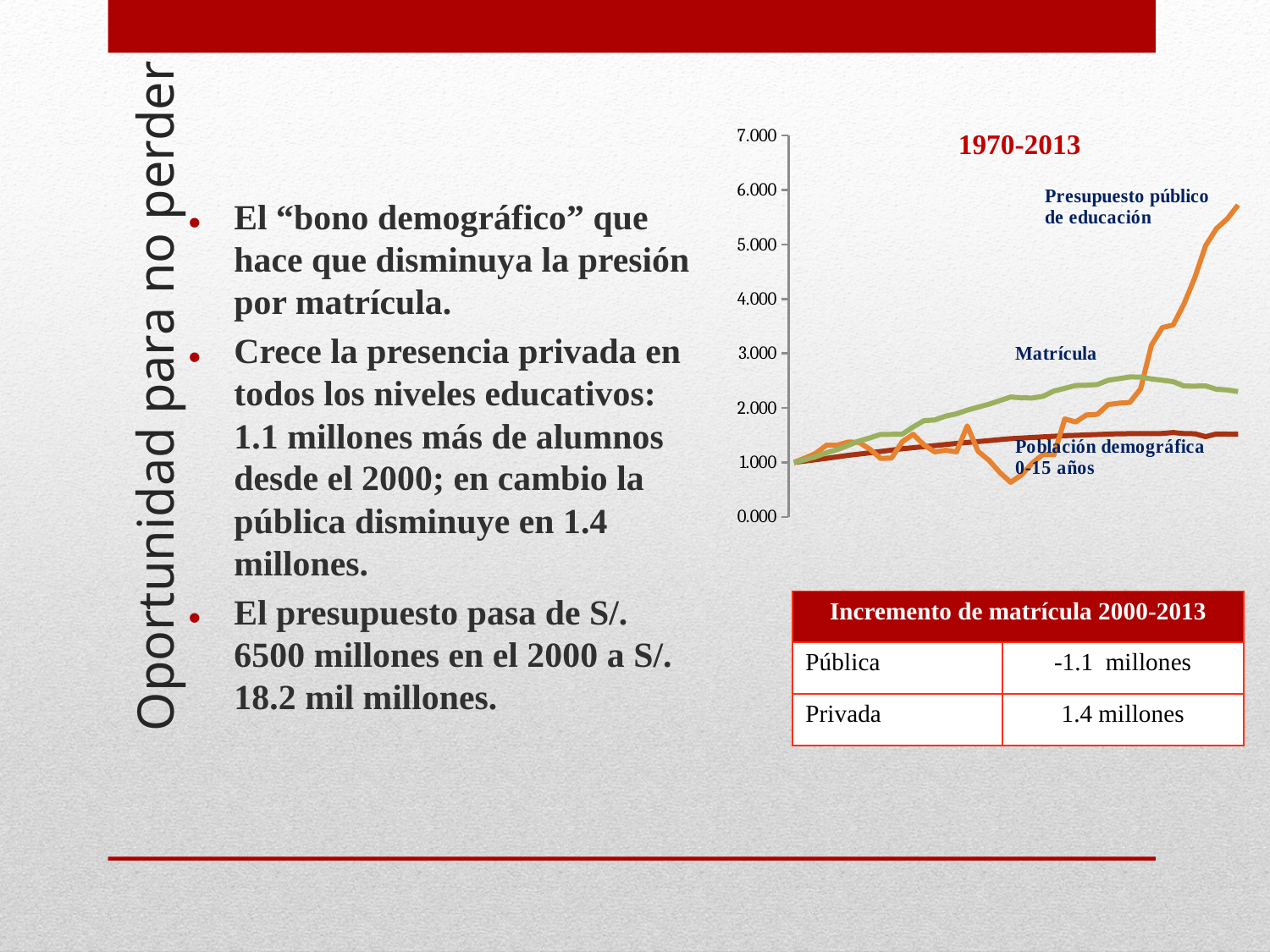
At the right end of the chart, which is higher: Matrícula or Población demográfica 0-15 años? Matrícula Is the final value of Presupuesto público de educación greater or less than 5.000? greater What is the title of the chart? 1970-2013 Does the Presupuesto público de educación series generally rise or fall from left to right? rise At the right end of the chart, which is higher: Presupuesto público de educación or Matrícula? Presupuesto público de educación Which series has the lowest value at the right end of the chart? Población demográfica 0-15 años How many series are plotted in the chart? 3 What is the highest value shown on the vertical axis of the chart? 7.000 Is the peak value of Matrícula greater or less than 3.000? less Is the final value of Población demográfica 0-15 años greater or less than 2.000? less Which series reaches the highest value in the chart? Presupuesto público de educación What kind of chart is shown on the slide? line chart